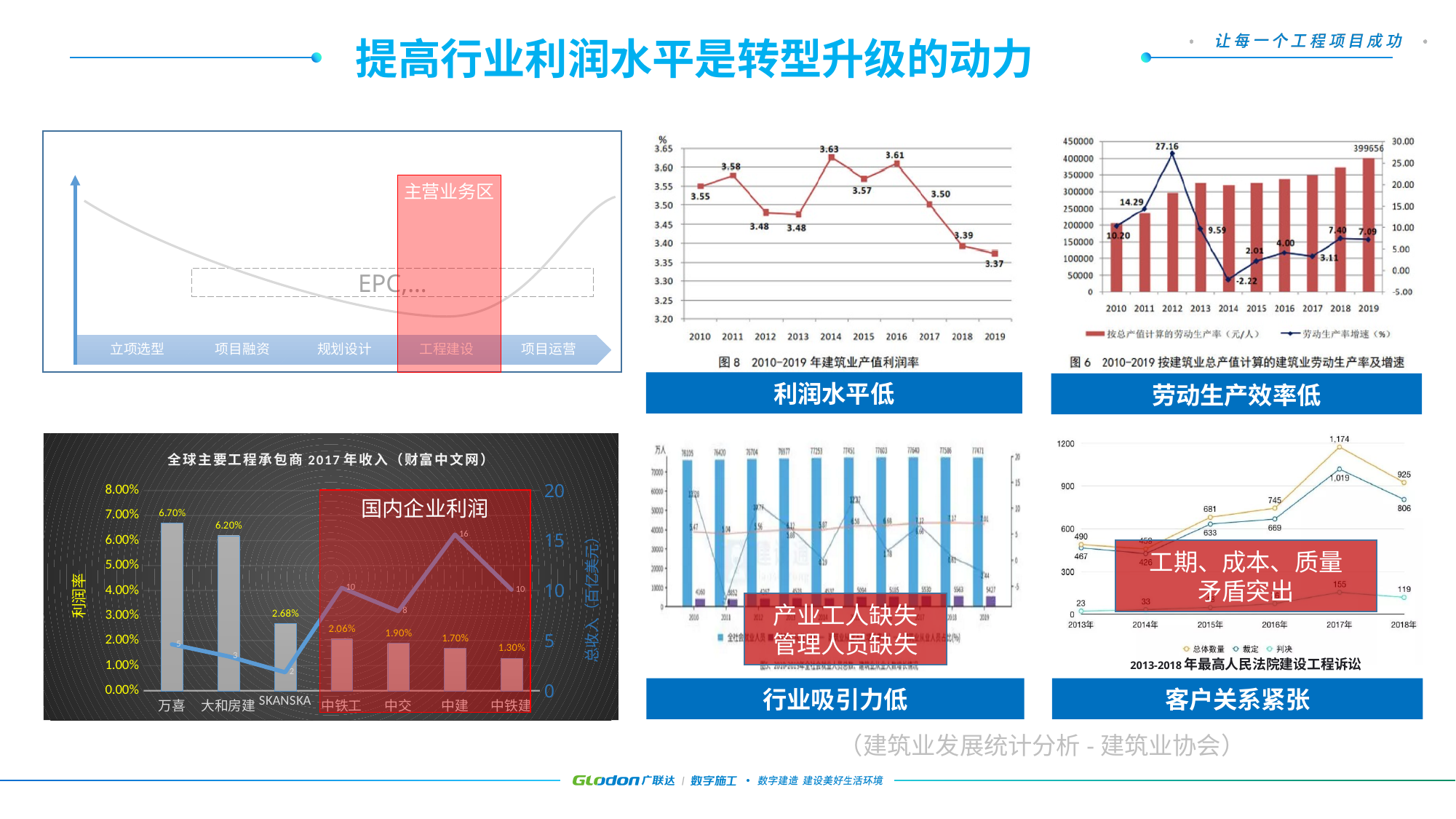
In the chart titled 全球主要工程承包商2017年收入（财富中文网）, what is the 利润率 for 万喜? 6.70% In the chart titled 图6 2010-2019按建筑业总产值计算的建筑业劳动生产率及增速, what is the 劳动生产率增速 value for 2012? 27.16 In the chart titled 图6 2010-2019按建筑业总产值计算的建筑业劳动生产率及增速, which year has the lowest 劳动生产率增速 value? 2014 In the chart titled 2013-2018年最高人民法院建设工程诉讼, how many series does the legend list? 3 In the chart titled 图8 2010-2019年建筑业产值利润率, which year has the lowest value? 2019 In the chart titled 2013-2018年最高人民法院建设工程诉讼, what is the 总体数量 value for 2017年? 1,174 In the chart titled 图8 2010-2019年建筑业产值利润率, what is the difference between the 2010 value and the 2019 value? 0.18 In the chart titled 全球主要工程承包商2017年收入（财富中文网）, which company has the lowest 利润率? 中铁建 In the chart titled 图8 2010-2019年建筑业产值利润率, how many years are plotted? 10 In the chart titled 全球主要工程承包商2017年收入（财富中文网）, which company has the highest 总收入 line value? 中建 In the chart titled 图8 2010-2019年建筑业产值利润率, what is the value for 2014? 3.63 In the chart titled 图6 2010-2019按建筑业总产值计算的建筑业劳动生产率及增速, what is the bar value labelled for 2019? 399656